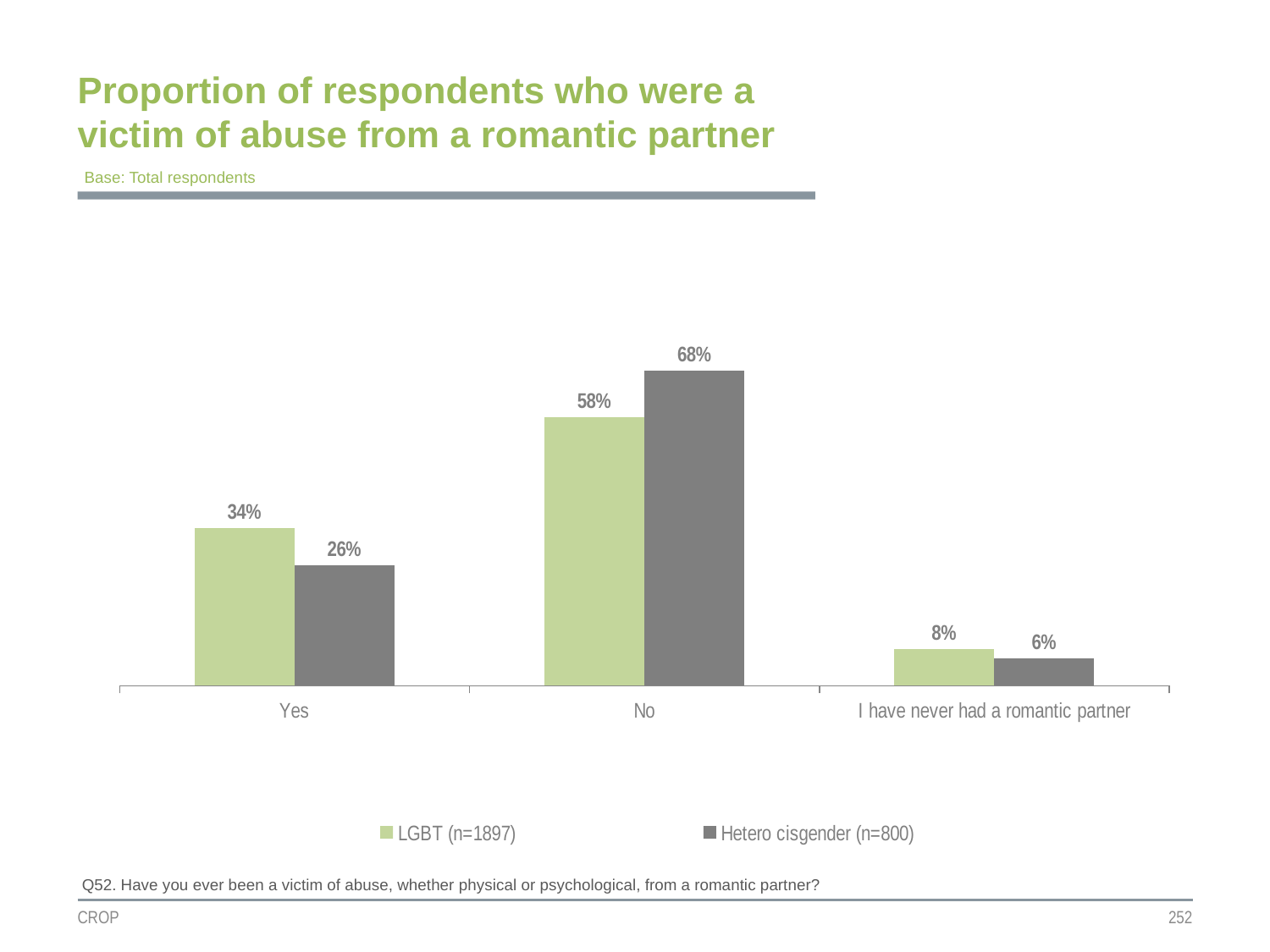
How many categories are shown on the x axis? 3 How many series does the legend list? 2 Which category has the lowest value for Hetero cisgender respondents? I have never had a romantic partner What is the difference between the LGBT and Hetero cisgender values for "Yes"? 8% What percentage of LGBT respondents answered "Yes"? 34% What is the sample size (n) for the LGBT group shown in the legend? 1897 For the "Yes" category, which group has the larger value, LGBT or Hetero cisgender? LGBT What is the difference between the Hetero cisgender and LGBT values for "No"? 10% Which category has the highest value for LGBT respondents? No What percentage of Hetero cisgender respondents answered "No"? 68% What is the value for Hetero cisgender respondents in the "I have never had a romantic partner" category? 6% What kind of chart is shown on the slide? Bar chart